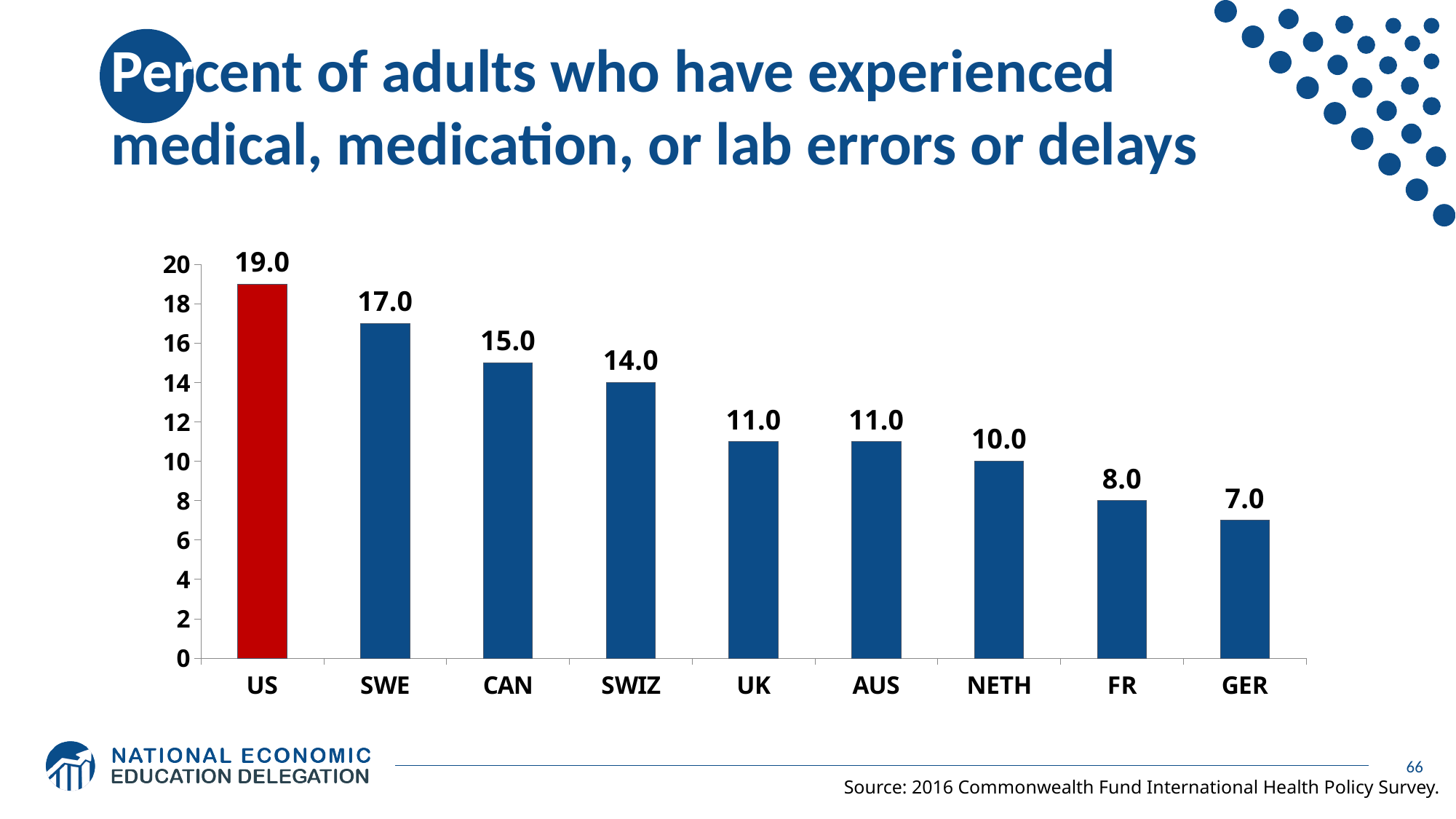
What is the difference between the values for CAN and GER? 8.0 Do the values rise or fall moving from left to right along the x axis? Fall Which bar is coloured red rather than blue? US What is the value for NETH? 10.0 What kind of chart is shown on the slide? Bar chart What is the difference between the values for the US and SWE? 2.0 Which country has the highest value? US What is the value for the US? 19.0 What is the value for SWIZ? 14.0 How many countries are shown on the chart? 9 Which country has the lowest value? GER Which is larger, the value for FR or the value for NETH? NETH